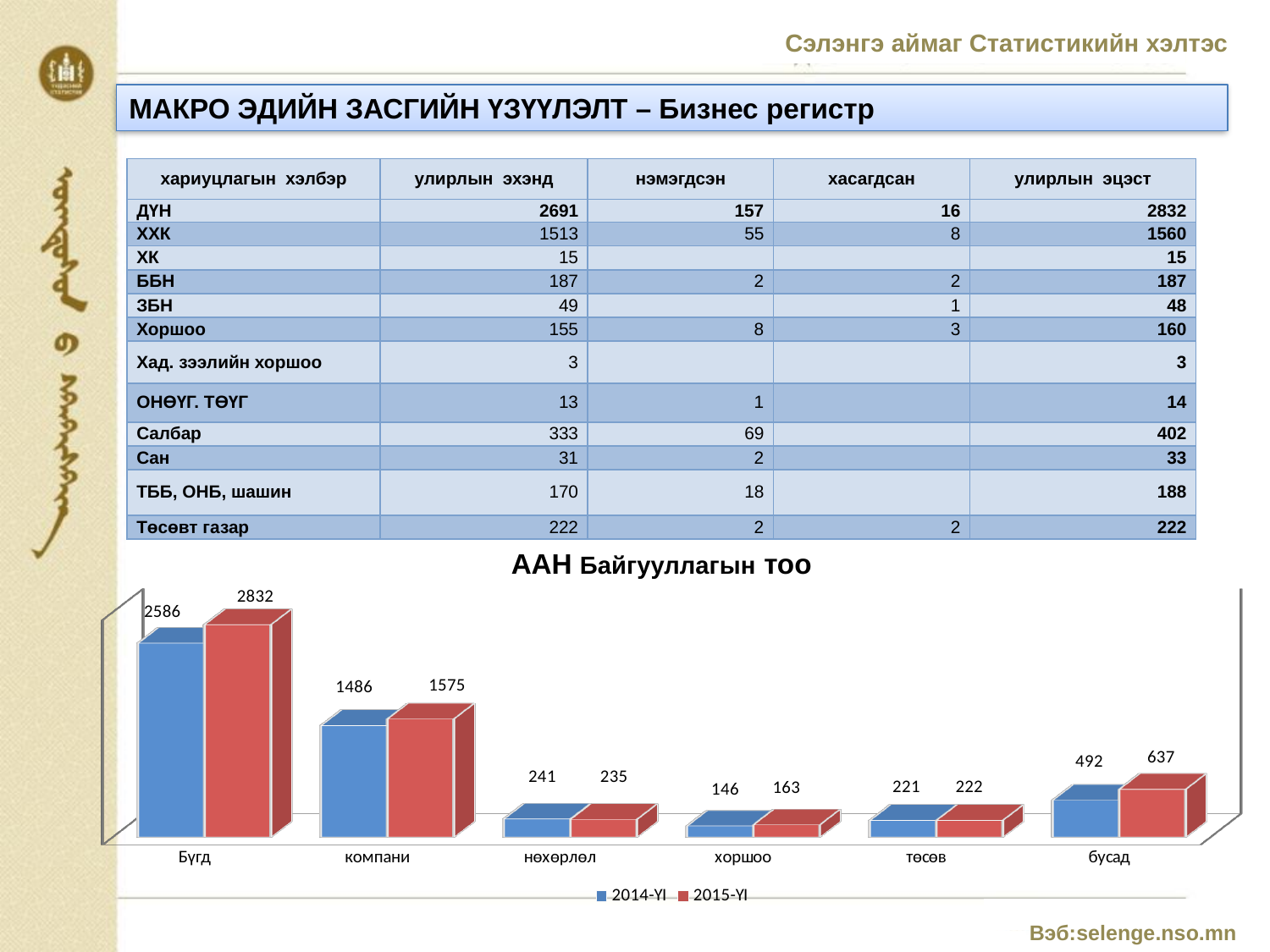
How many series does the chart legend list? 2 How many categories are shown on the x axis of the chart? 6 What is the value for Бүгд in the 2015-YI series? 2832 What is the value for компани in the 2014-YI series? 1486 What is the difference between the 2015-YI and 2014-YI values for Бүгд? 246 What is the difference between the 2015-YI and 2014-YI values for бусад? 145 What is the title of the chart? ААН Байгууллагын тоо What is the value for бусад in the 2015-YI series? 637 What kind of chart is shown on the slide? bar chart Which is larger for нөхөрлөл: the 2014-YI value or the 2015-YI value? 2014-YI Which category has the highest value in the 2015-YI series? Бүгд Which category has the lowest value in the 2014-YI series? хоршоо